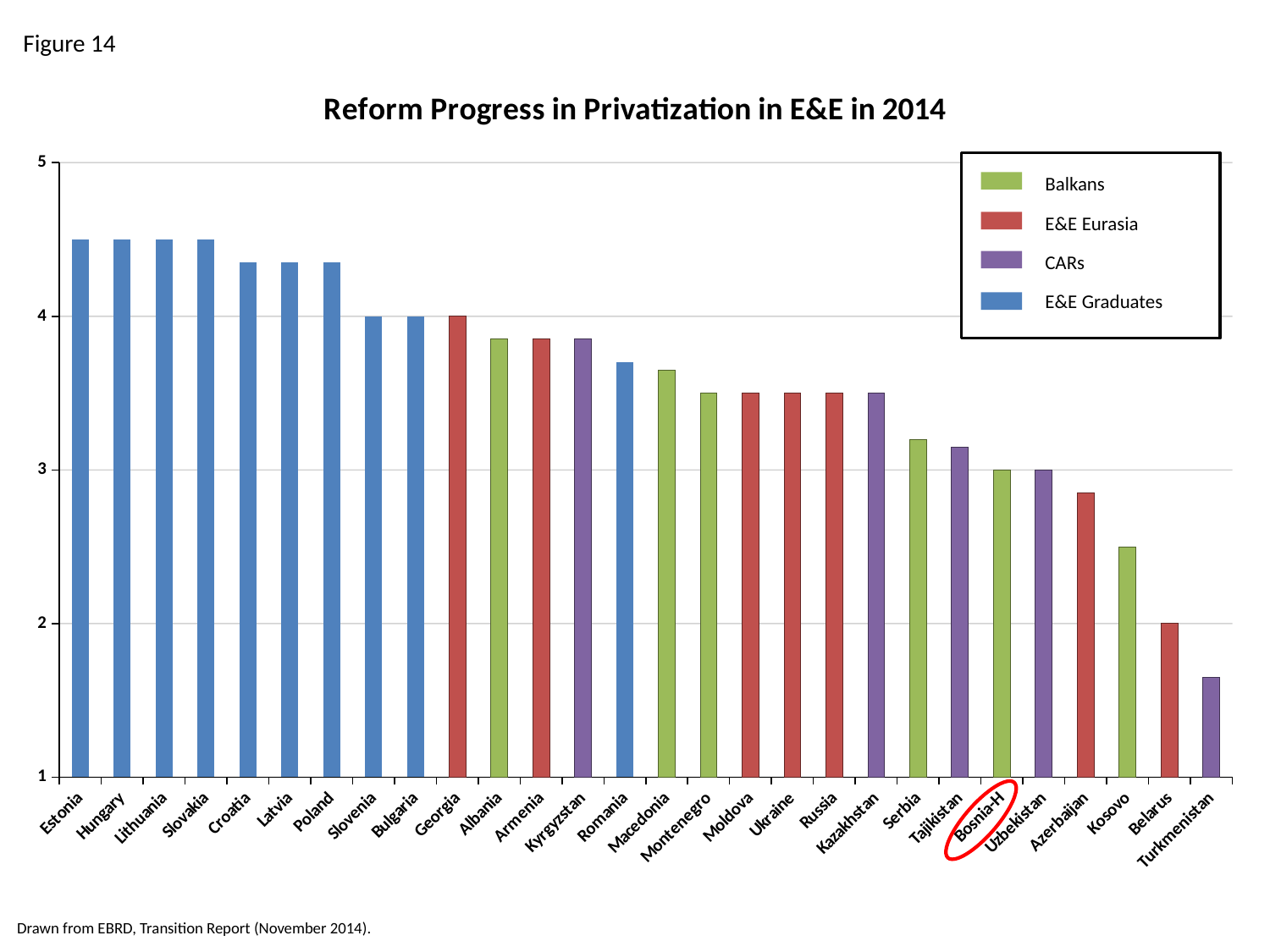
Which country has the lowest value? Turkmenistan What is the value for Georgia? 4 What is the value for Uzbekistan? 3 How many series does the legend list? 4 What is the difference between the value for Georgia and the value for Belarus? 2 What is the value for Belarus? 2 What is the title of the chart? Reform Progress in Privatization in E&E in 2014 What type of chart is shown on the slide? bar chart Is the value for Azerbaijan greater or less than 3? less Is the value for Estonia greater or less than 4? greater Which is larger, the value for Kosovo or the value for Belarus? Kosovo How many countries are shown on the x axis? 28